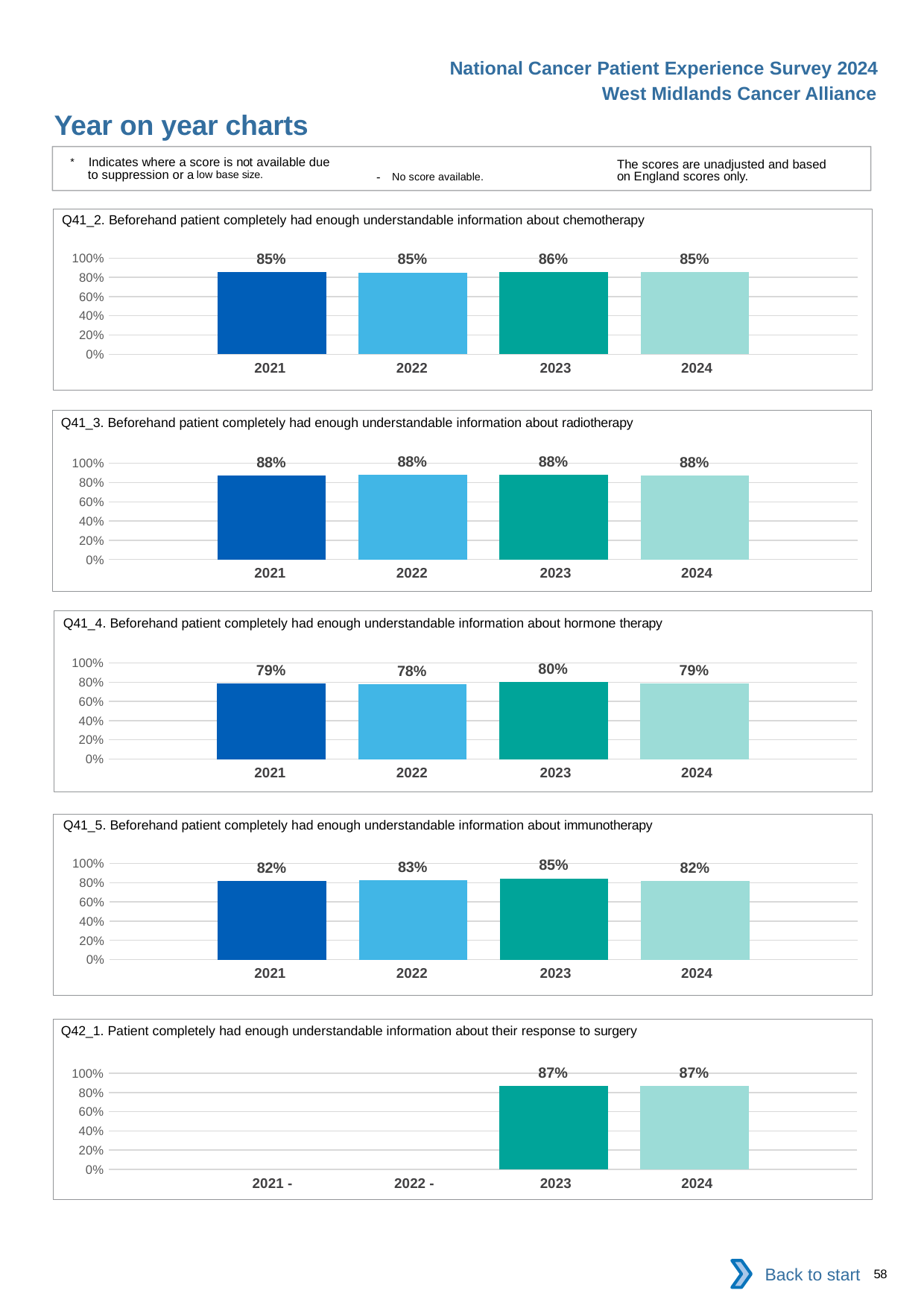
What kind of chart is the Q41_2 chart (information about chemotherapy)? Bar chart In the Q41_5 chart (information about immunotherapy), what is the difference between the 2023 and 2024 values? 3 percentage points In the Q41_4 chart (information about hormone therapy), which year has the lowest value? 2022 In the Q41_2 chart (information about chemotherapy), is the value for 2021 greater or less than 80%? greater In the Q41_4 chart (information about hormone therapy), which year has the highest value? 2023 In the Q42_1 chart (information about response to surgery), what is the value for 2023? 87% In the Q41_3 chart (information about radiotherapy), do the values change from 2021 to 2024? No, they stay at 88% In the Q41_5 chart (information about immunotherapy), which is larger, the value for 2022 or the value for 2023? 2023 In the Q41_3 chart (information about radiotherapy), what is the value for 2024? 88% In the Q42_1 chart (information about response to surgery), how many years have a bar plotted? 2 In the Q41_2 chart (information about chemotherapy), what is the value for 2023? 86% How many charts are shown on the slide? 5